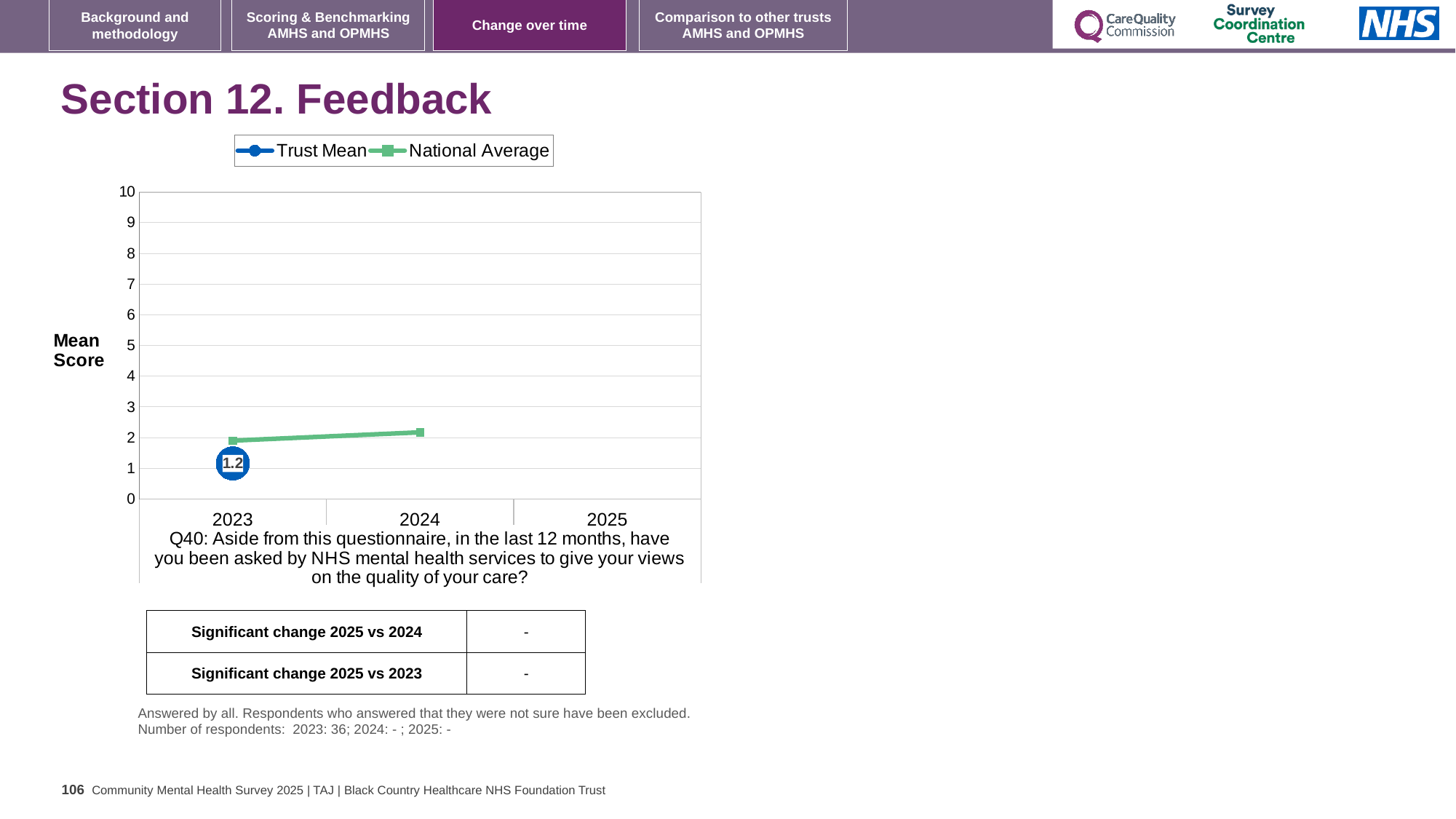
What is the label on the y axis? Mean Score What are the two series named in the legend? Trust Mean and National Average Is the National Average value for 2024 greater or less than 1? greater How many years are shown on the x axis? 3 What is the highest value shown on the y axis? 10 Does the National Average rise or fall from 2023 to 2024? rise What is the Trust Mean value for 2023? 1.2 In 2023, which is higher: the Trust Mean or the National Average? National Average What kind of chart is shown on the slide? line chart Is the Trust Mean value for 2023 greater or less than 2? less How many series does the legend list? 2 Is the National Average value for 2023 greater or less than 3? less